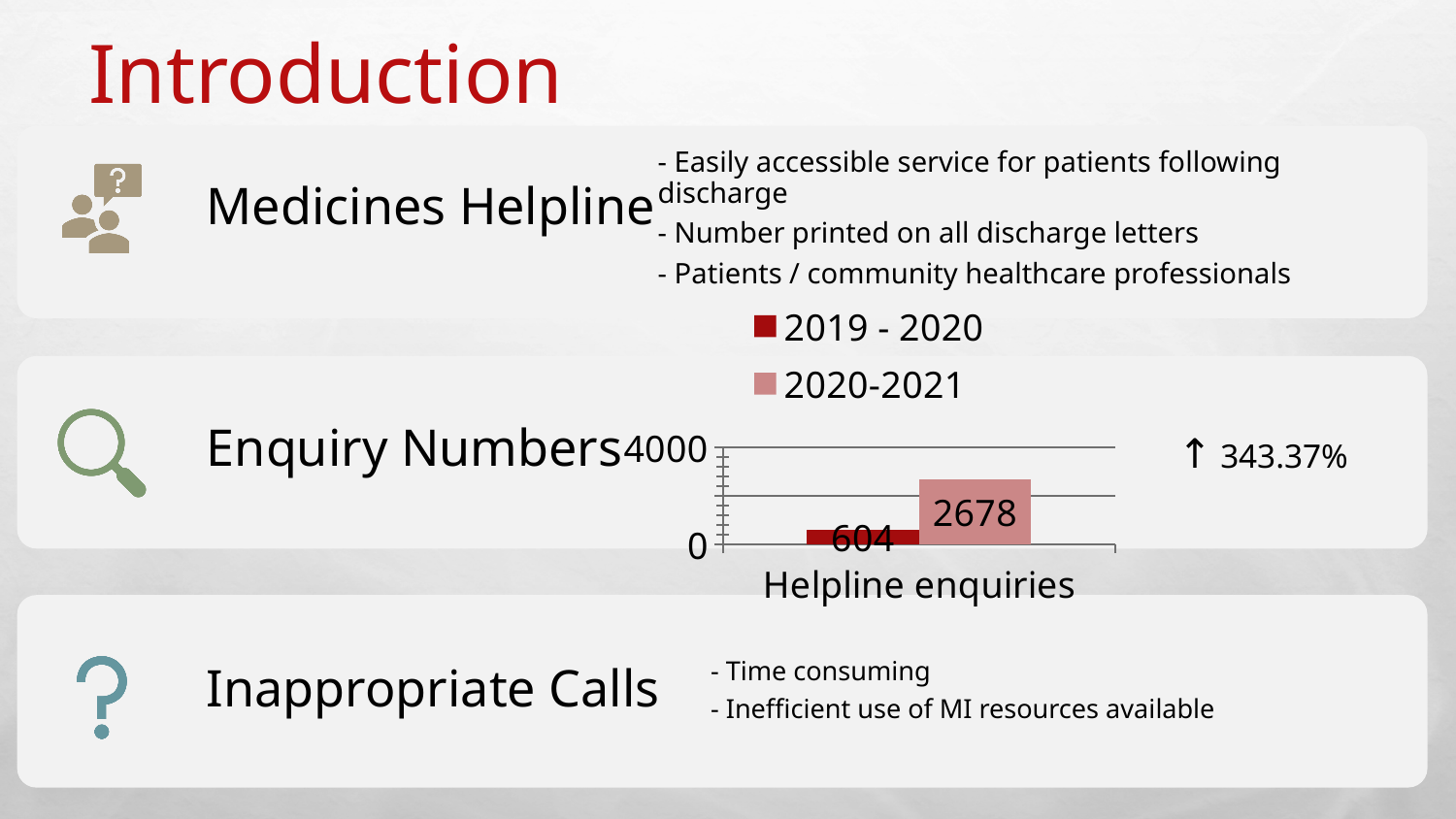
How many series does the legend of the Helpline enquiries chart list? 2 What is the value for the 2020-2021 series in the Helpline enquiries chart? 2678 What is the maximum value shown on the y axis of the Helpline enquiries chart? 4000 Which series has the higher value for Helpline enquiries, 2019 - 2020 or 2020-2021? 2020-2021 How many categories are shown on the x axis of the Helpline enquiries chart? 1 What is the category label on the x axis of the chart? Helpline enquiries Which series has the highest value in the Helpline enquiries chart? 2020-2021 What is the value for the 2019 - 2020 series in the Helpline enquiries chart? 604 What is the difference between the 2020-2021 and 2019 - 2020 values for Helpline enquiries? 2074 Is the value for 2020-2021 Helpline enquiries greater or less than 4000? less Which series has the lowest value in the Helpline enquiries chart? 2019 - 2020 What kind of chart is used to show the Helpline enquiries data? bar chart